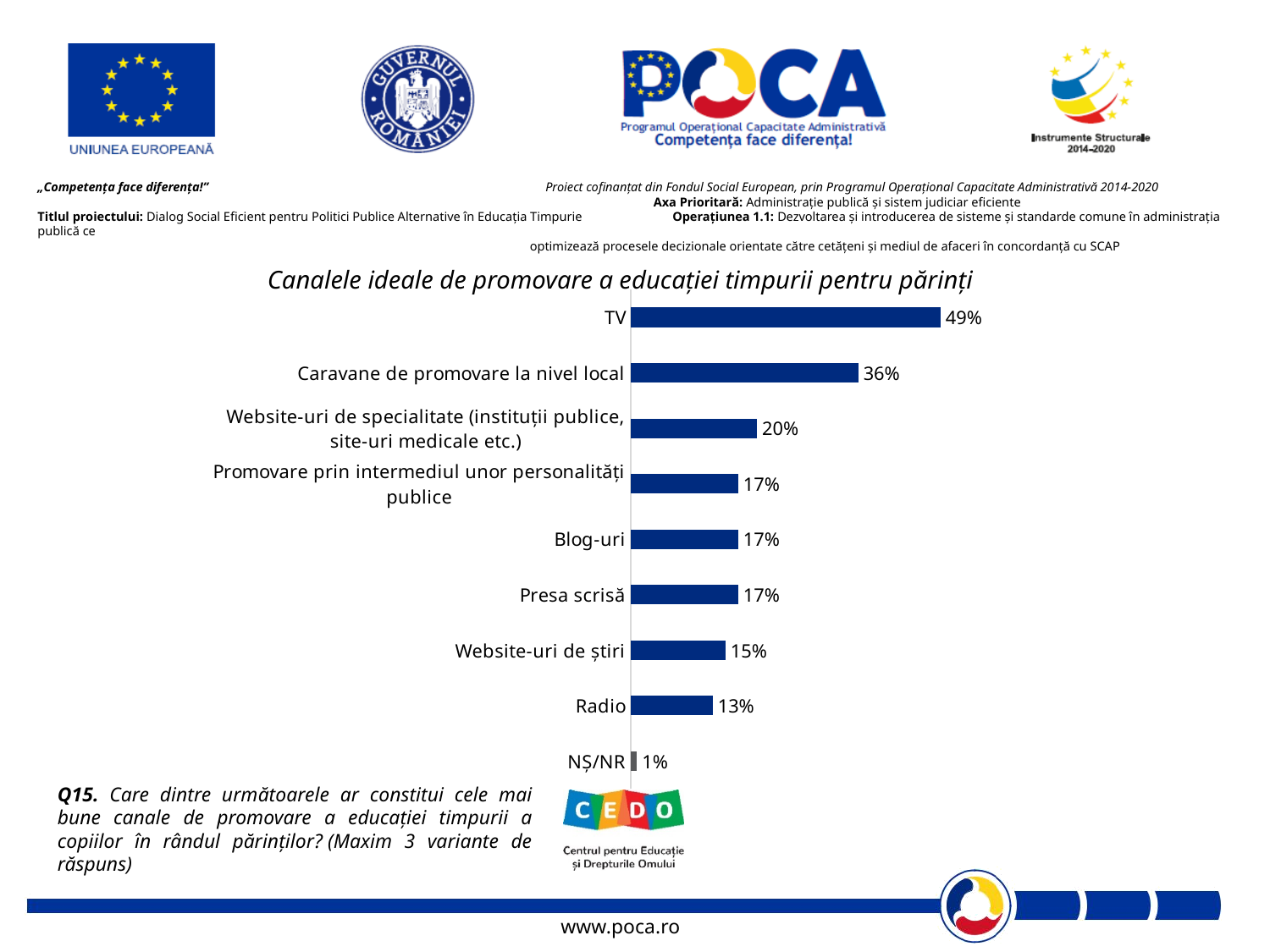
Which category has the highest value? TV Which category has the lowest value? NȘ/NR What is the value for Radio? 13% Which is larger, the value for Website-uri de specialitate (instituții publice, site-uri medicale etc.) or the value for Blog-uri? Website-uri de specialitate (instituții publice, site-uri medicale etc.) What is the difference between the values for Radio and NȘ/NR? 12% What is the difference between the values for TV and Caravane de promovare la nivel local? 13% What is the value for TV? 49% What is the value for Website-uri de știri? 15% What is the title of the chart? Canalele ideale de promovare a educației timpurii pentru părinți What is the value for Caravane de promovare la nivel local? 36% How many categories are shown in the chart? 9 What kind of chart is shown on the slide? Bar chart